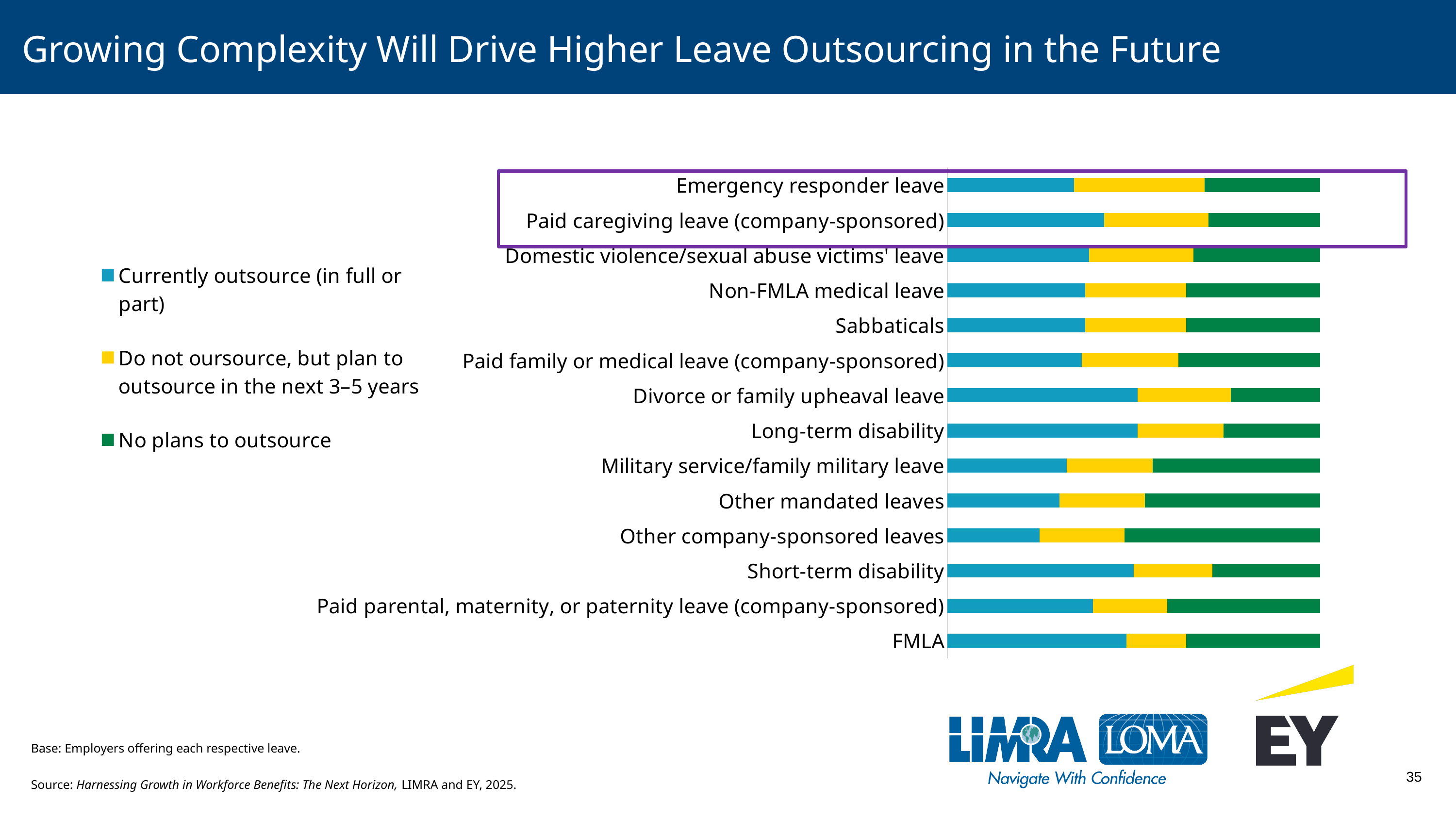
Which has the smaller 'Currently outsource (in full or part)' segment: FMLA or Emergency responder leave? Emergency responder leave Which colour represents 'No plans to outsource' in the legend? Green Which has the larger 'Do not oursource, but plan to outsource in the next 3–5 years' segment: Emergency responder leave or FMLA? Emergency responder leave Which two leave types are highlighted with a purple box at the top of the chart? Emergency responder leave and Paid caregiving leave (company-sponsored) How many leave types (categories) are plotted in the chart? 14 Which has the larger 'No plans to outsource' segment: Military service/family military leave or Paid caregiving leave (company-sponsored)? Military service/family military leave How many series does the legend list? 3 Which leave type has the largest 'Do not oursource, but plan to outsource in the next 3–5 years' segment? Emergency responder leave Which leave type has the largest 'No plans to outsource' segment? Other company-sponsored leaves What kind of chart is shown on the slide? Stacked bar chart